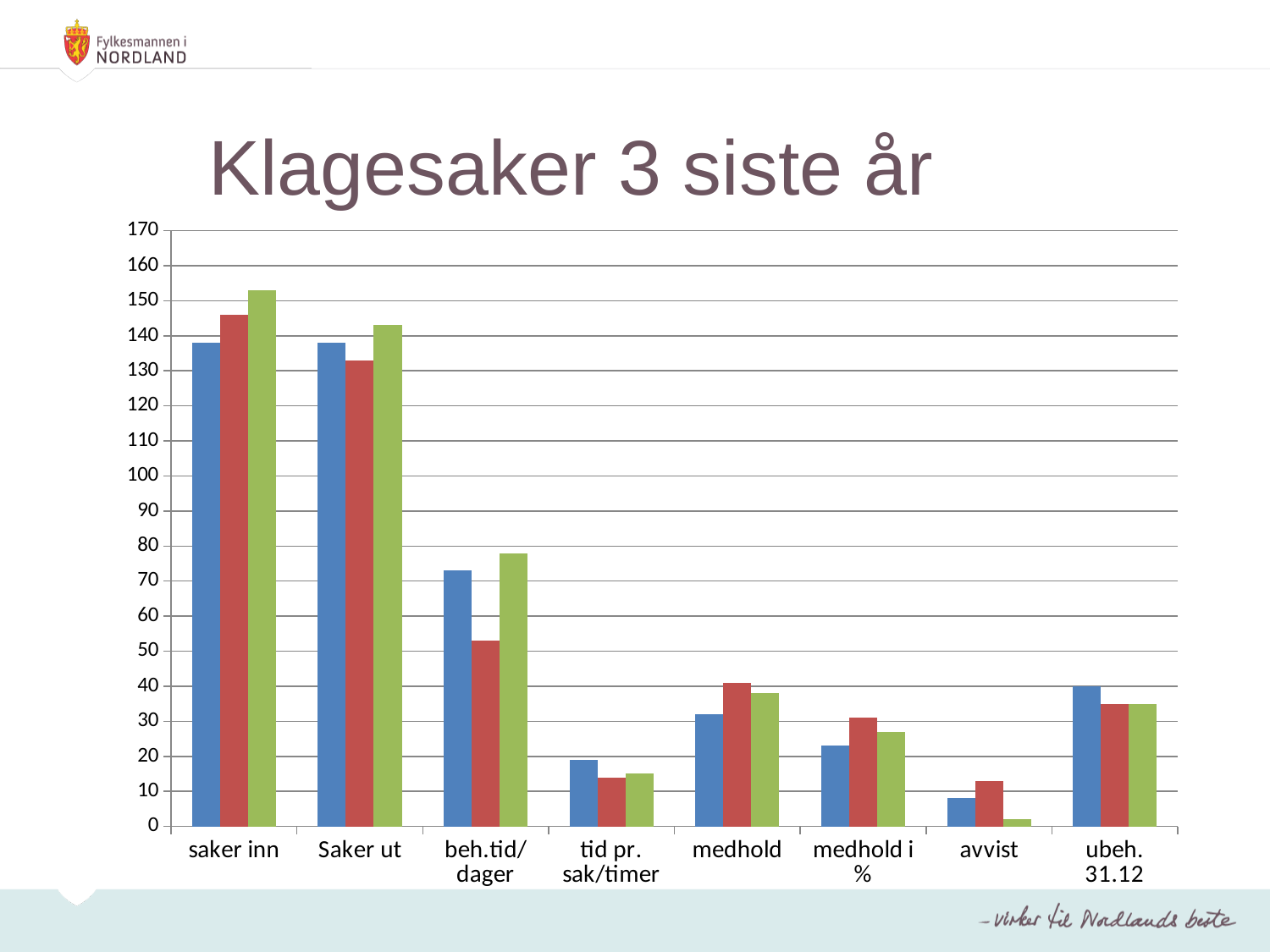
What is the title of the chart? Klagesaker 3 siste år Which category contains the tallest bar in the chart? saker inn What kind of chart is shown on the slide? bar chart Is the green bar for 'avvist' greater or less than 10? less For 'Saker ut', which is larger: the blue bar or the red bar? the blue bar How many categories are shown on the x axis of the chart? 8 Which category contains the shortest bar in the chart? avvist How many bars are plotted for each category in the chart? 3 Is the blue bar for 'beh.tid/dager' greater or less than 60? greater Is the blue bar for 'saker inn' greater or less than 130? greater For 'saker inn', which is larger: the blue bar or the green bar? the green bar